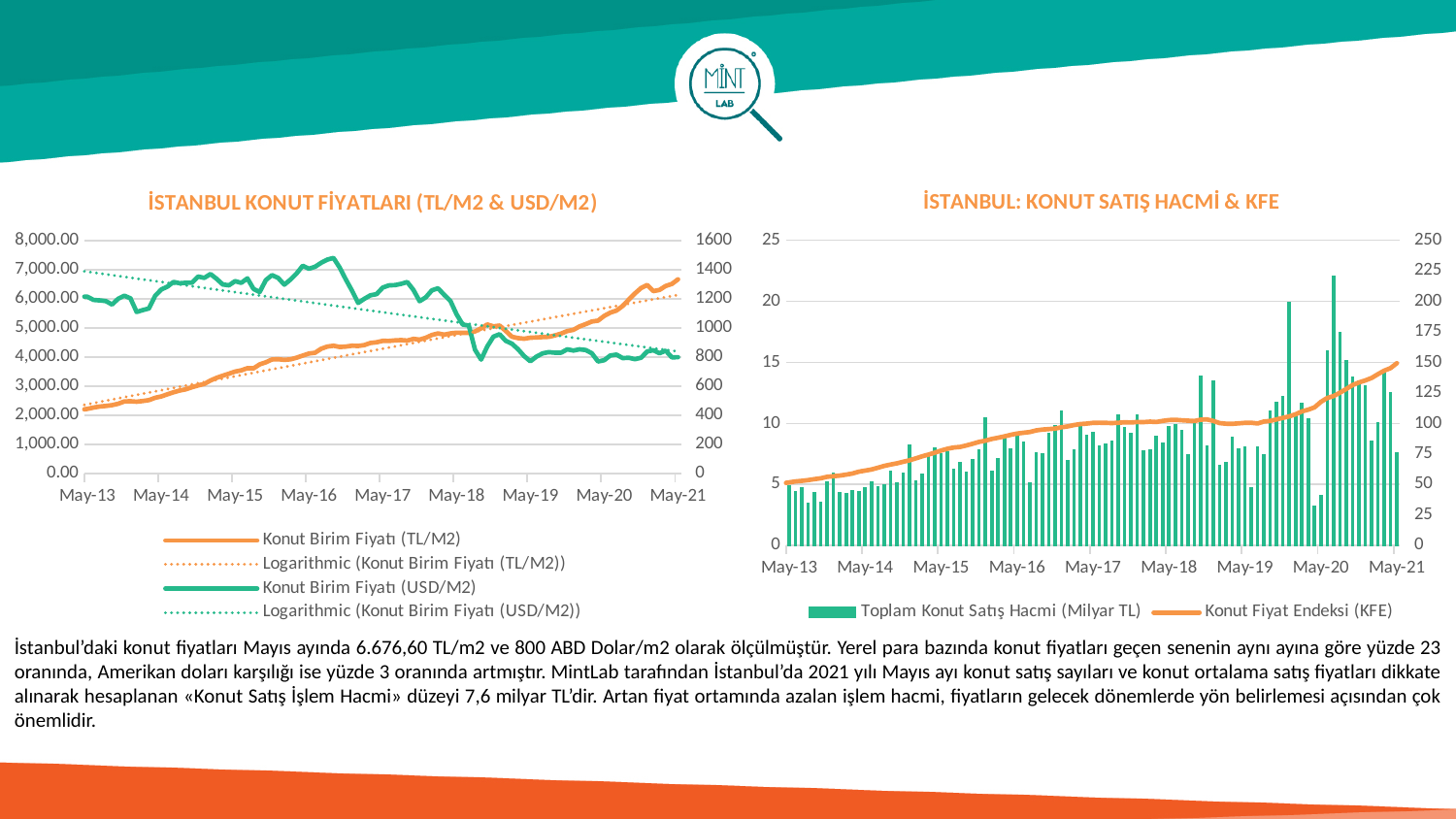
What kind of chart is the left chart titled 'İSTANBUL KONUT FİYATLARI (TL/M2 & USD/M2)'? line chart How many entries does the legend of the left chart 'İSTANBUL KONUT FİYATLARI (TL/M2 & USD/M2)' list? 4 In the left chart 'İSTANBUL KONUT FİYATLARI (TL/M2 & USD/M2)', does the 'Konut Birim Fiyatı (USD/M2)' series rise or fall from May-13 to May-21? fall In the left chart 'İSTANBUL KONUT FİYATLARI (TL/M2 & USD/M2)', does the 'Konut Birim Fiyatı (TL/M2)' series rise or fall from May-13 to May-21? rise How many entries does the legend of the right chart 'İSTANBUL: KONUT SATIŞ HACMİ & KFE' list? 2 In the right chart 'İSTANBUL: KONUT SATIŞ HACMİ & KFE', which series is drawn as bars? Toplam Konut Satış Hacmi (Milyar TL) In the left chart 'İSTANBUL KONUT FİYATLARI (TL/M2 & USD/M2)', is the value of 'Konut Birim Fiyatı (USD/M2)' at May-21 greater or less than 1000 on the right axis? less In the right chart 'İSTANBUL: KONUT SATIŞ HACMİ & KFE', is the tallest 'Toplam Konut Satış Hacmi (Milyar TL)' bar greater or less than 20 on the left axis? greater In the right chart 'İSTANBUL: KONUT SATIŞ HACMİ & KFE', does the 'Konut Fiyat Endeksi (KFE)' line rise or fall from May-13 to May-21? rise What is the first label on the x axis of the left chart 'İSTANBUL KONUT FİYATLARI (TL/M2 & USD/M2)'? May-13 In the right chart 'İSTANBUL: KONUT SATIŞ HACMİ & KFE', is the value of 'Konut Fiyat Endeksi (KFE)' at May-21 greater or less than 125 on the right axis? greater